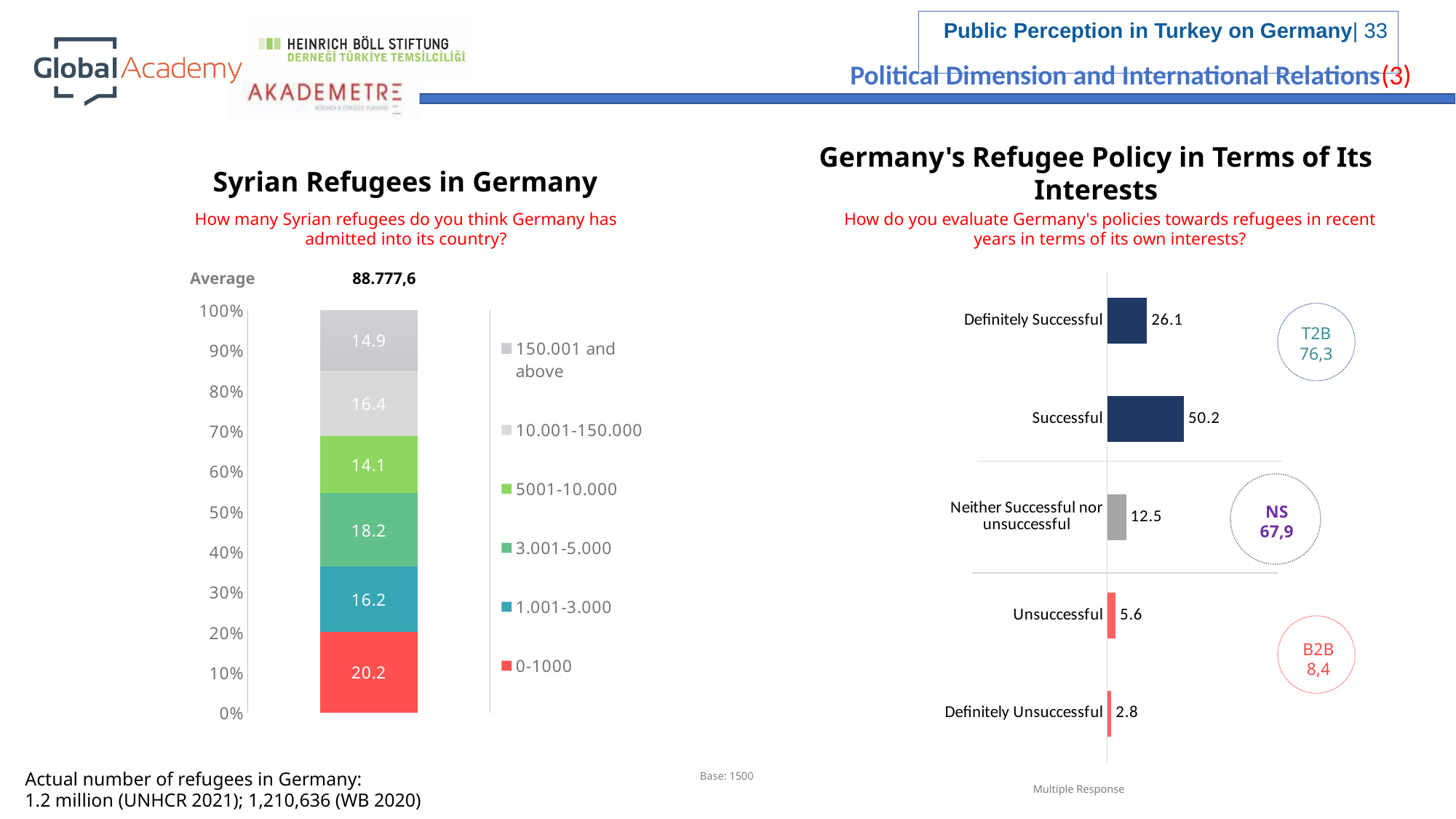
What kind of chart is the 'Germany's Refugee Policy in Terms of Its Interests' chart? Bar chart In the 'Germany's Refugee Policy in Terms of Its Interests' chart, what is the value for 'Successful'? 50.2 In the 'Syrian Refugees in Germany' chart, how many segments does the legend list? 6 In the 'Syrian Refugees in Germany' chart, what is the difference between the '0-1000' and '150.001 and above' values? 5.3 In the 'Syrian Refugees in Germany' chart, what average is shown above the chart? 88.777,6 In the 'Syrian Refugees in Germany' chart, what is the value for the '0-1000' segment? 20.2 In the 'Germany's Refugee Policy in Terms of Its Interests' chart, what is the value for 'Definitely Unsuccessful'? 2.8 In the 'Syrian Refugees in Germany' chart, what is the value for the '3.001-5.000' segment? 18.2 In the 'Germany's Refugee Policy in Terms of Its Interests' chart, which category has the highest value? Successful In the 'Syrian Refugees in Germany' chart, which segment has the largest value? 0-1000 In the 'Germany's Refugee Policy in Terms of Its Interests' chart, which is larger: 'Definitely Successful' or 'Neither Successful nor unsuccessful'? Definitely Successful In the 'Syrian Refugees in Germany' chart, which segment has the smallest value? 5001-10.000